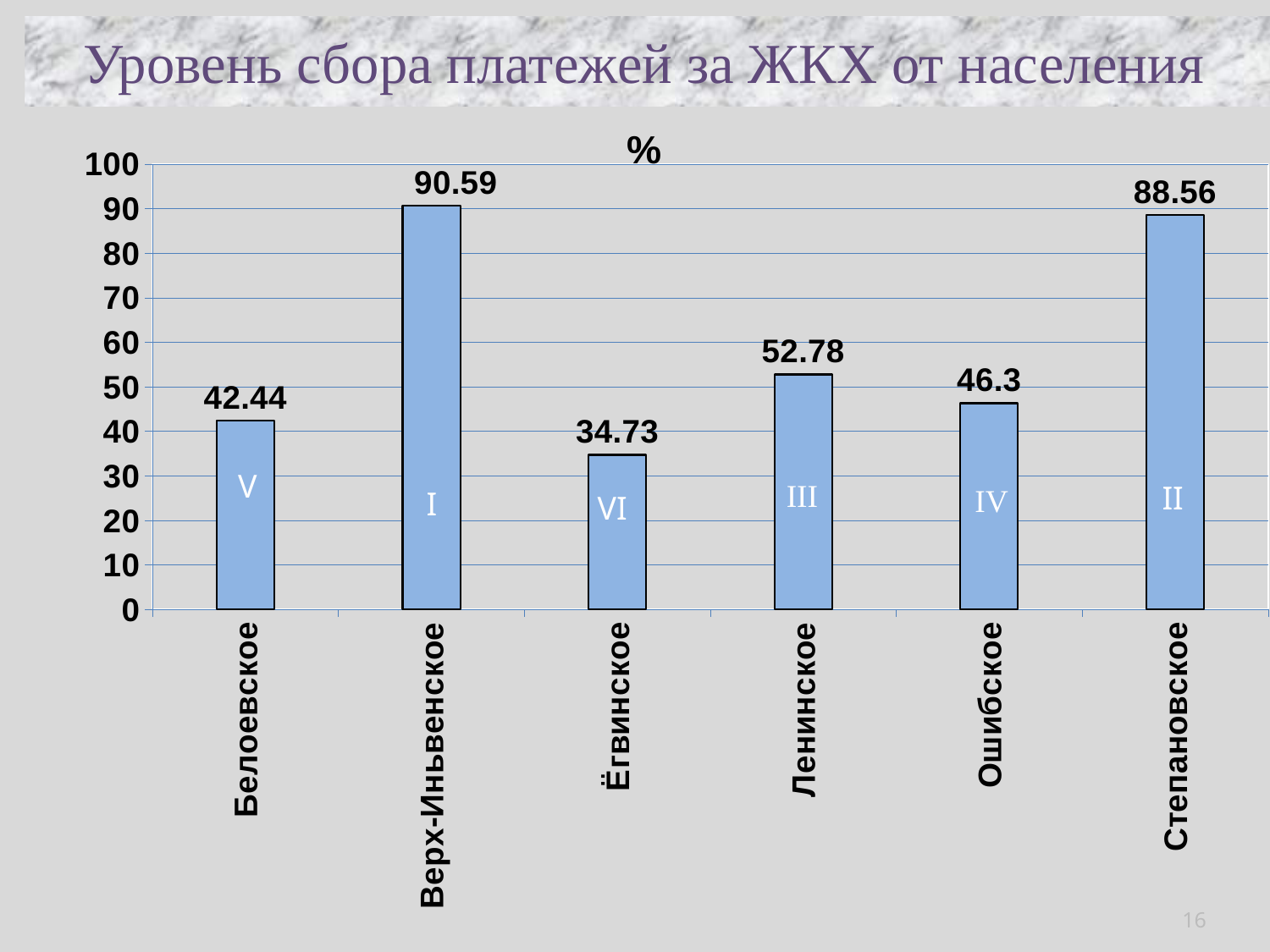
What is the difference between the values for Ленинское and Белоевское? 10.34 Which category has the highest value? Верх-Иньвенское What kind of chart is shown on the slide? bar chart How many categories are shown on the x axis? 6 Is the value for Степановское greater or less than 80? greater What is the value for Ошибское? 46.3 Which is larger, the value for Ленинское or the value for Ошибское? Ленинское What Roman numeral is printed inside the bar for Степановское? II What is the value for Верх-Иньвенское? 90.59 What is the difference between the values for Верх-Иньвенское and Степановское? 2.03 What is the value for Ёгвинское? 34.73 Which category has the lowest value? Ёгвинское